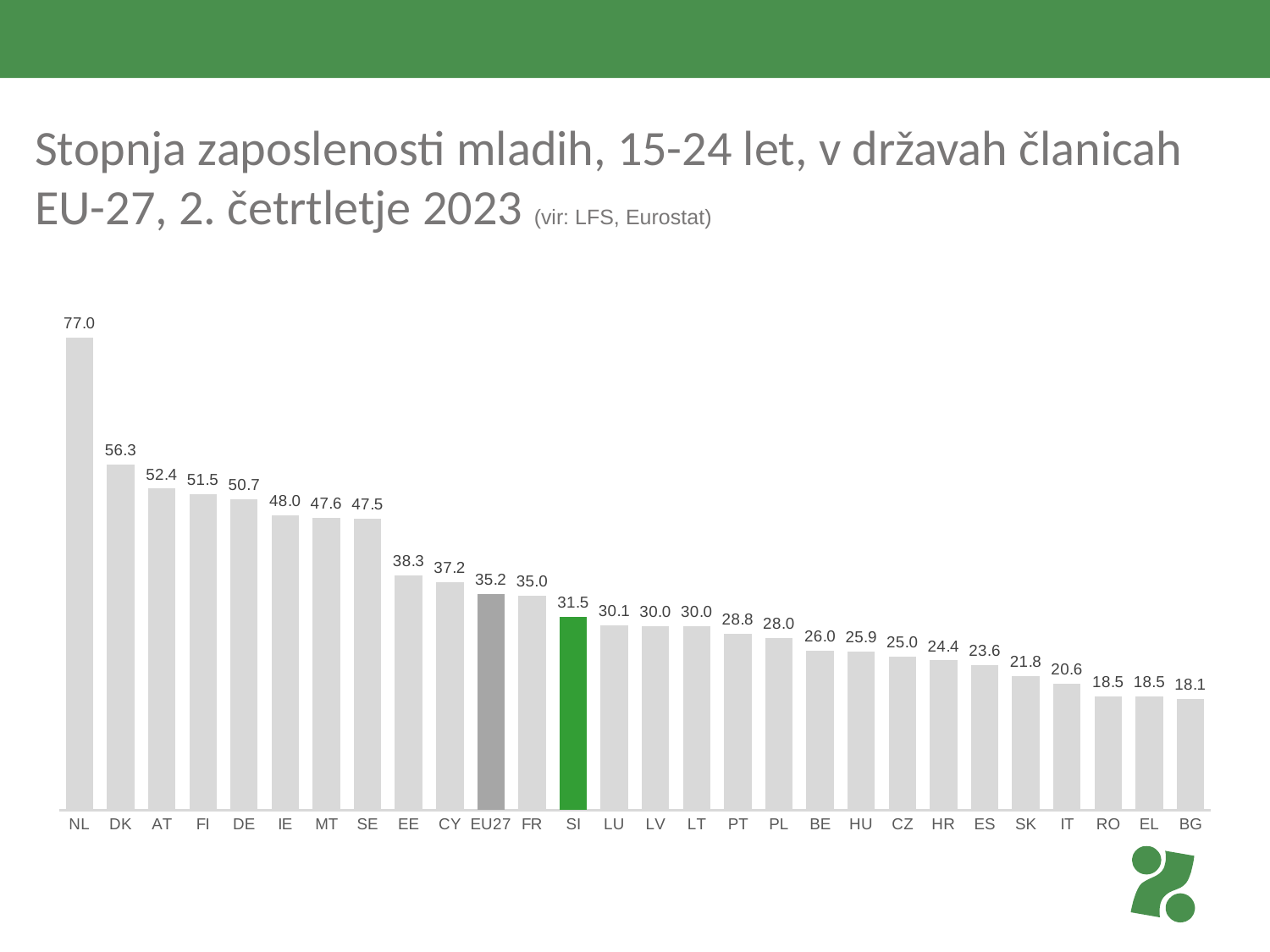
What kind of chart is shown on the slide? Bar chart Do the values rise or fall from left to right along the x axis? Fall What is the value for DK? 56.3 Which category's bar is coloured green? SI What is the difference between the values for EU27 and SI? 3.7 What is the difference between the values for NL and DK? 20.7 Which category has the lowest value? BG What is the value for EU27? 35.2 Which category has the highest value? NL Which is larger, the value for EE or the value for FR? EE What is the value for SI? 31.5 How many bars are plotted in the chart? 28